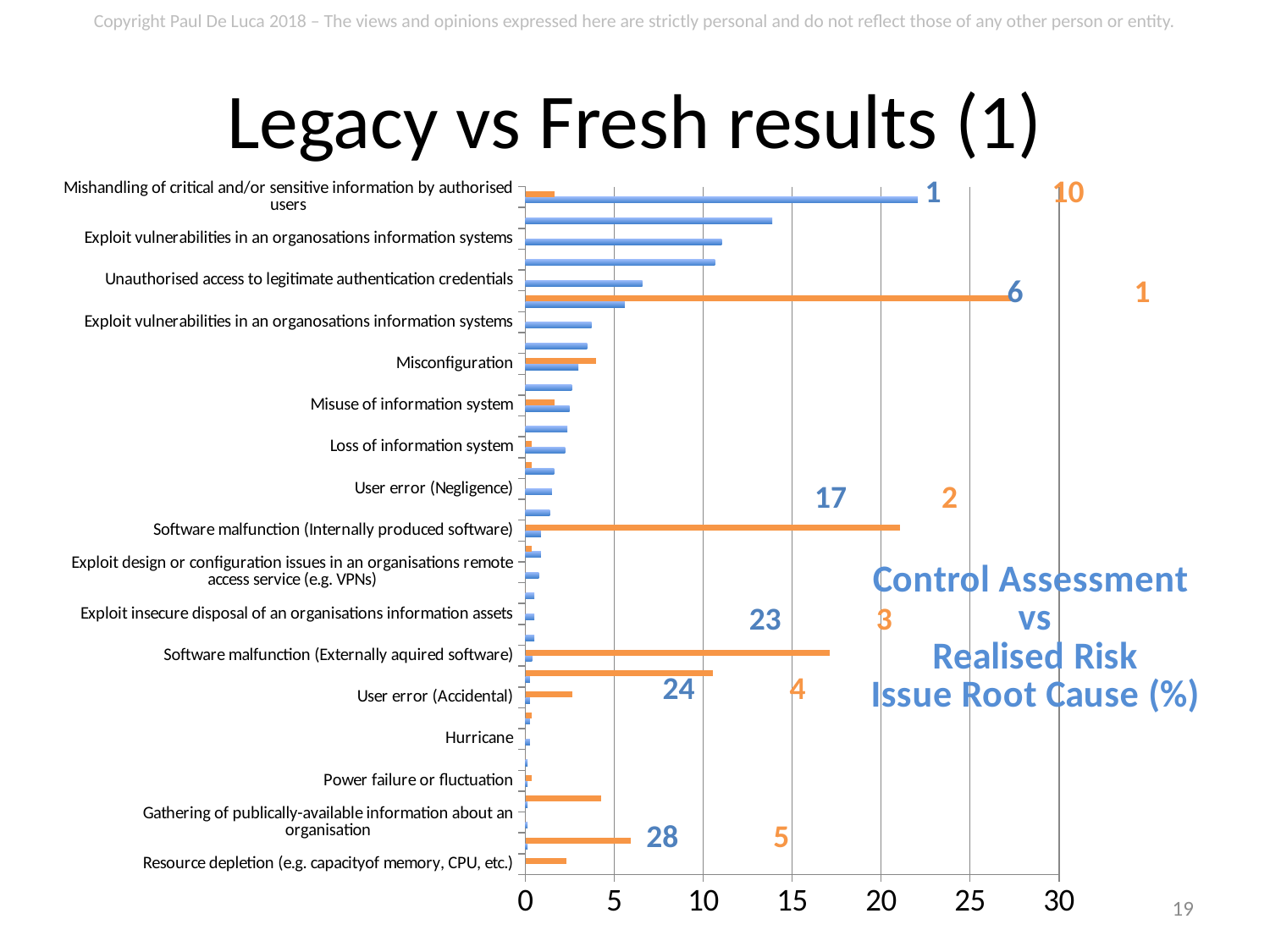
Which has the longer orange bar: 'Software malfunction (Internally produced software)' or 'Misconfiguration'? Software malfunction (Internally produced software) What type of chart is shown on the slide? bar chart Is the blue bar for 'Software malfunction (Internally produced software)' greater or less than 5? less Which has the longer blue bar: 'Mishandling of critical and/or sensitive information by authorised users' or 'Misconfiguration'? Mishandling of critical and/or sensitive information by authorised users Is the orange bar for 'Software malfunction (Internally produced software)' greater or less than 15? greater What title text is shown on the chart? Control Assessment vs Realised Risk Issue Root Cause (%) Is the blue bar for 'Hurricane' greater or less than 5? less What is the highest value shown on the horizontal axis? 30